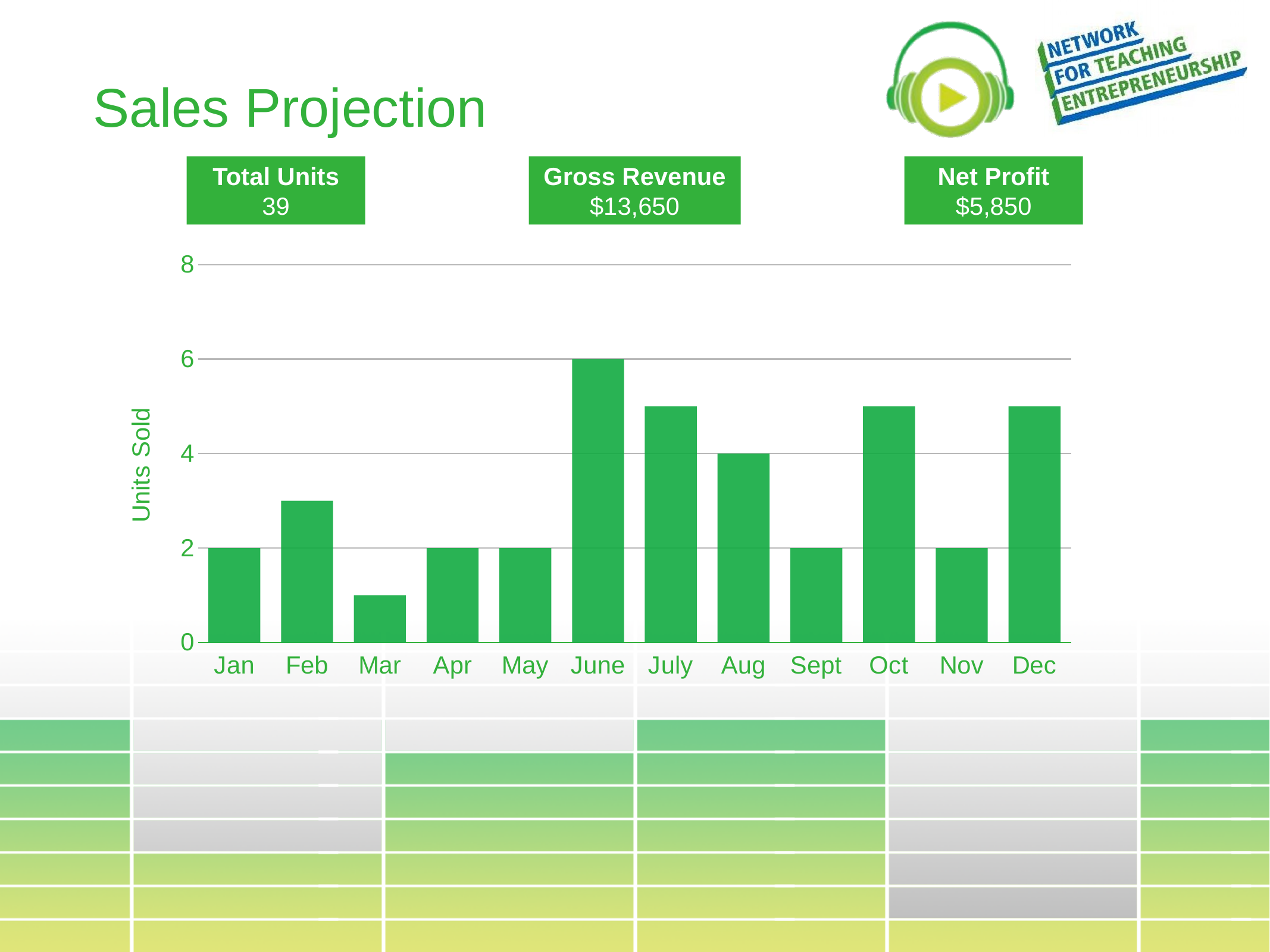
Which month has more units sold, June or Aug? June How many units are sold in Jan? 2 What type of chart is shown on the slide? bar chart How many months are shown on the x axis of the chart? 12 Is the value for Feb greater or less than 2? greater Which month has the lowest number of units sold? Mar How many units are sold in June? 6 What is the label on the y axis of the chart? Units Sold Which month has the highest number of units sold? June Is the value for July greater or less than 4? greater How many units are sold in Aug? 4 What is the difference in units sold between June and Aug? 2